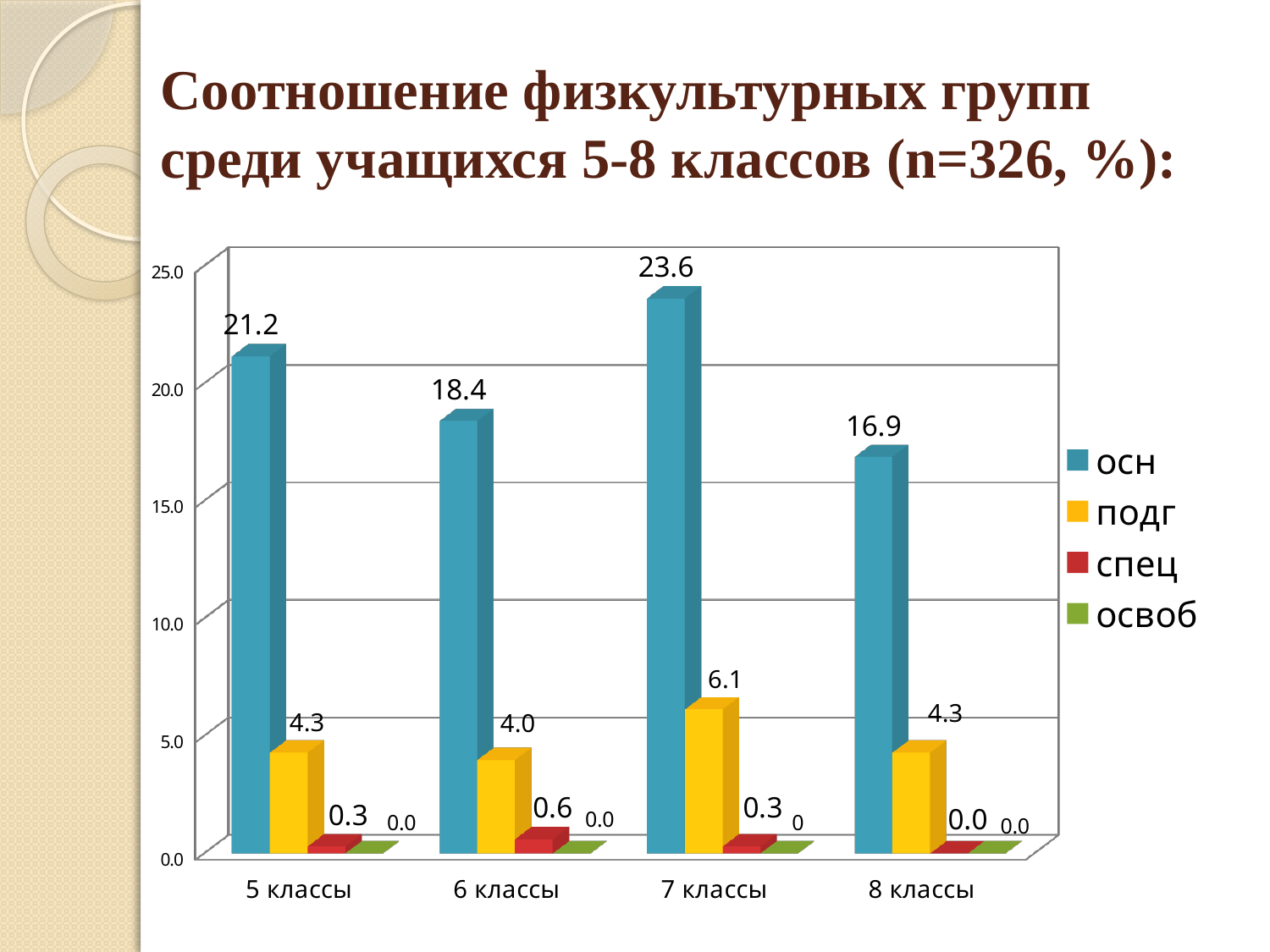
What kind of chart is shown on the slide? bar chart Which is larger, the подг value for 7 классы or for 5 классы? 7 классы What is the value for осн in 8 классы? 16.9 What is the value for подг in 6 классы? 4.0 How many class groups are shown on the x axis? 4 What is the value for спец in 6 классы? 0.6 Which class group has the lowest value for осн? 8 классы What is the value for осн in 7 классы? 23.6 How many series does the legend list? 4 What is the difference between the осн values for 7 классы and 8 классы? 6.7 Which class group has the highest value for осн? 7 классы Which series is shown in yellow in the legend? подг